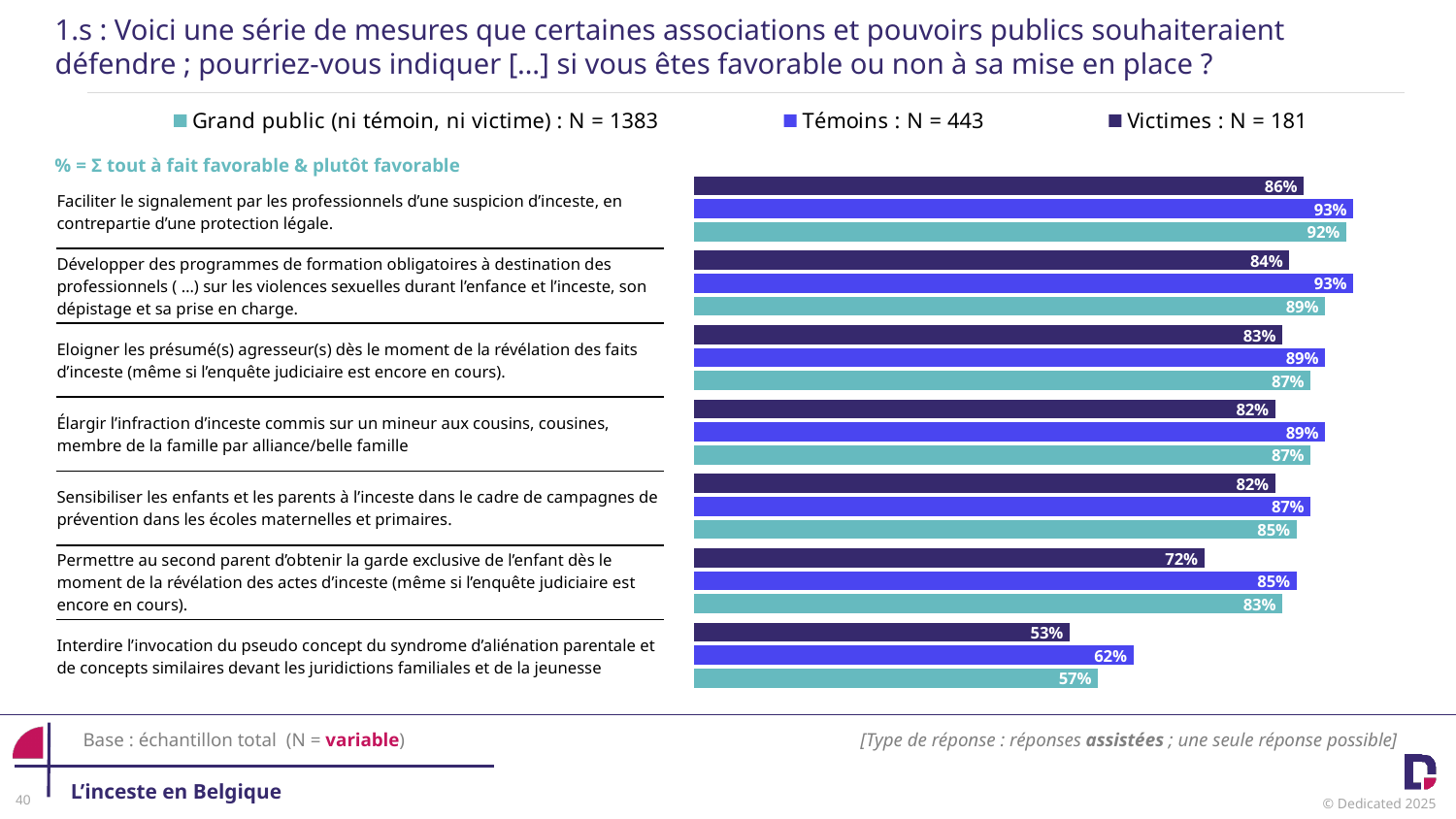
What type of chart is shown on the slide? bar chart Which measure has the highest value for Grand public? Faciliter le signalement par les professionnels d'une suspicion d'inceste, en contrepartie d'une protection légale What is the value for Victimes for 'Permettre au second parent d'obtenir la garde exclusive de l'enfant'? 72% How many measures (categories) are shown in the chart? 7 What is the value for Grand public for 'Développer des programmes de formation obligatoires à destination des professionnels'? 89% What is the sample size (N) for the Victimes series according to the legend? 181 What is the value for Témoins for 'Faciliter le signalement par les professionnels d'une suspicion d'inceste'? 93% For 'Sensibiliser les enfants et les parents à l'inceste', which is larger: the Témoins value or the Grand public value? Témoins How many series does the legend list? 3 Which measure has the lowest value for Victimes? Interdire l'invocation du pseudo concept du syndrome d'aliénation parentale et de concepts similaires What is the value for Grand public for 'Interdire l'invocation du pseudo concept du syndrome d'aliénation parentale'? 57% What is the difference between the Témoins and Victimes values for 'Permettre au second parent d'obtenir la garde exclusive de l'enfant'? 13 percentage points